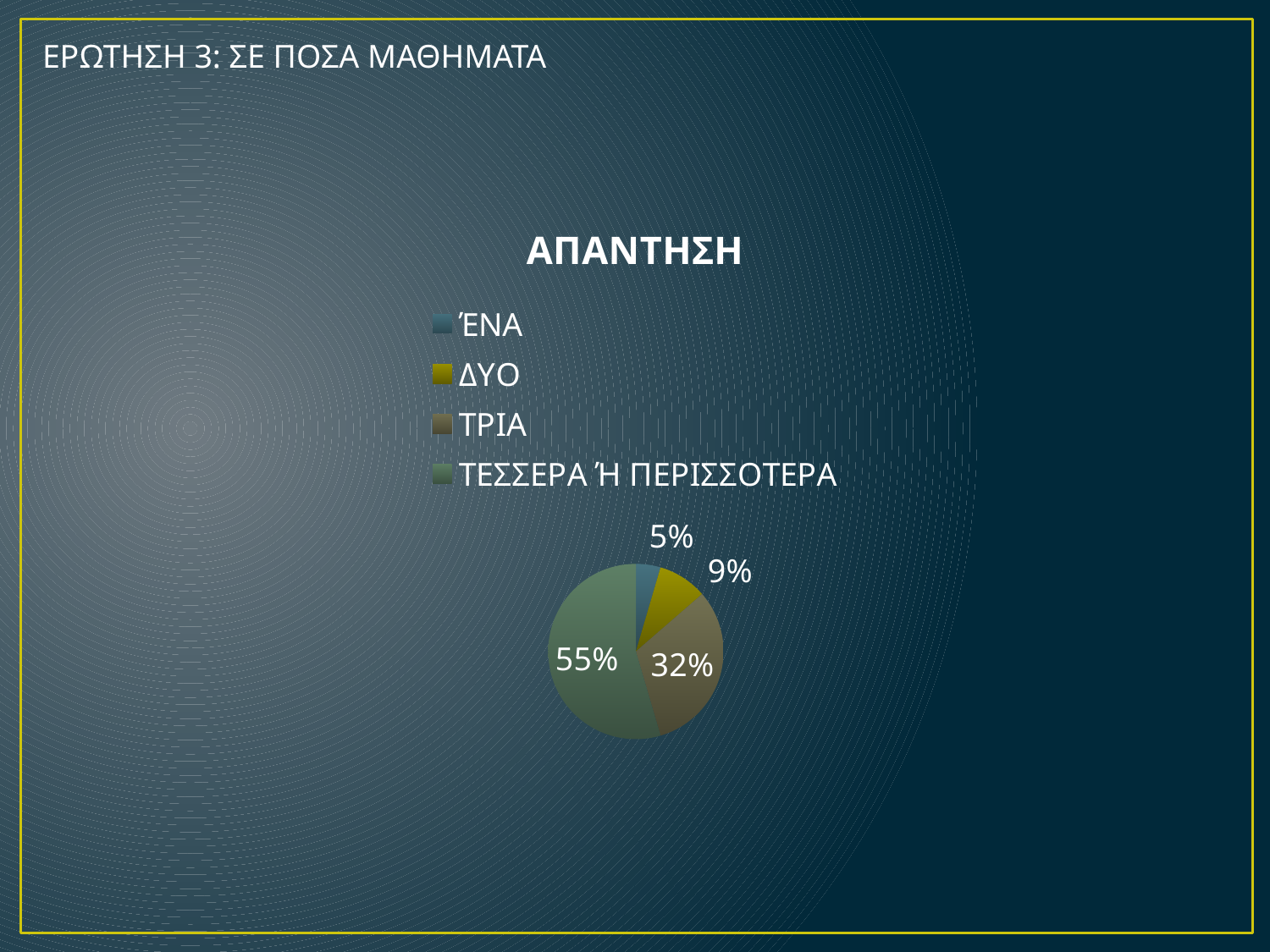
Which category has the largest slice of the pie? ΤΕΣΣΕΡΑ Ή ΠΕΡΙΣΣΟΤΕΡΑ What share of the pie does ΔΥΟ represent? 9% Which is larger, the share for ΔΥΟ or the share for ΤΡΙΑ? ΤΡΙΑ What share of the pie does ΤΡΙΑ represent? 32% What share of the pie does ΈΝΑ represent? 5% What is the title of the chart? ΑΠΑΝΤΗΣΗ How many categories does the legend of the pie chart list? 4 What kind of chart is shown on the slide? pie chart Which category has the smallest slice of the pie? ΈΝΑ What is the combined share of ΈΝΑ and ΔΥΟ? 14% What is the difference in percentage points between ΤΕΣΣΕΡΑ Ή ΠΕΡΙΣΣΟΤΕΡΑ and ΤΡΙΑ? 23%